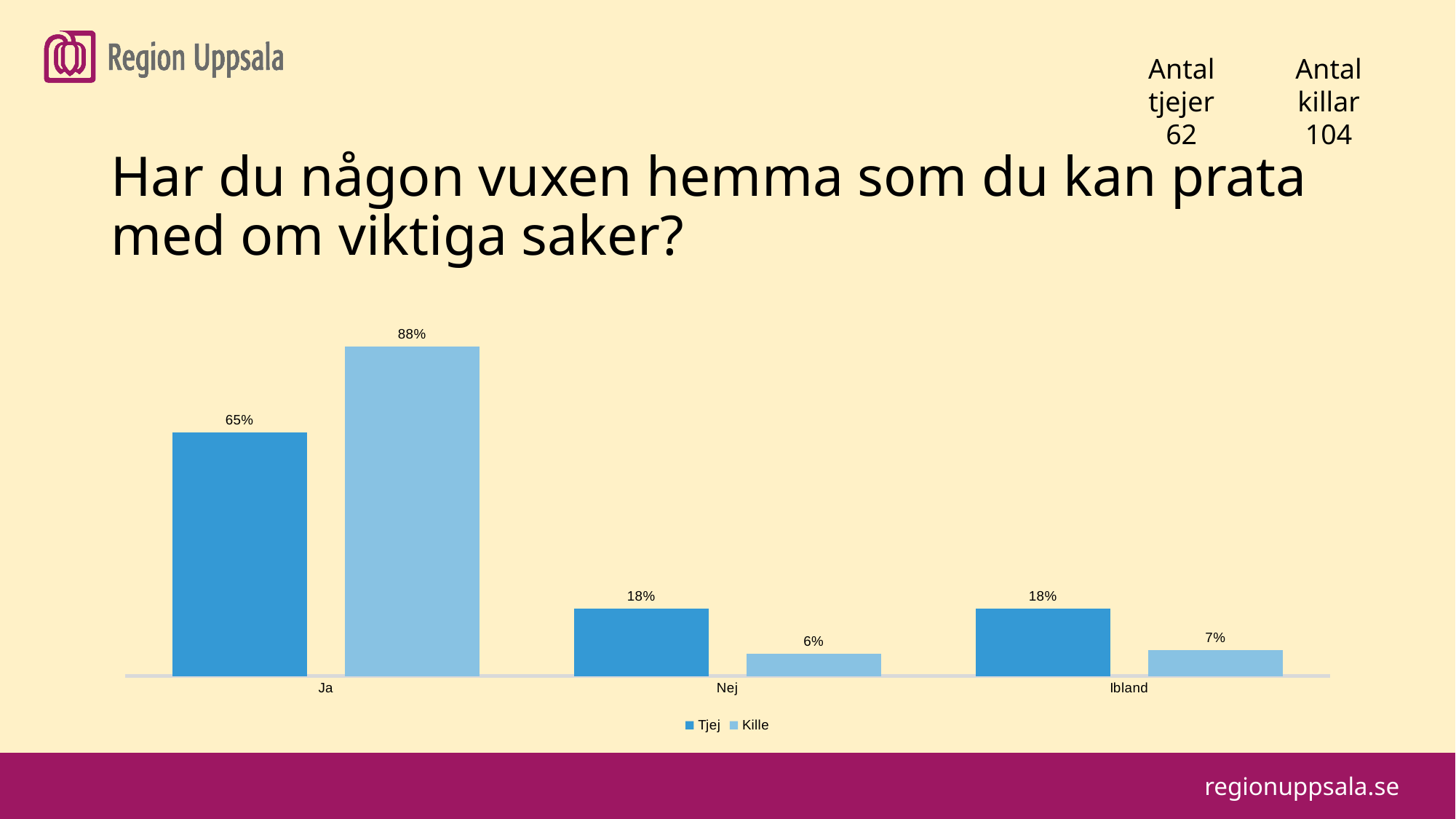
How many series does the legend list? 2 What is the value for Tjej in the Ja category? 65% What is the value for Tjej in the Ibland category? 18% What are the two series names listed in the legend? Tjej and Kille What is the value for Kille in the Nej category? 6% What is the value for Kille in the Ja category? 88% How many categories are shown on the x axis? 3 What kind of chart is shown on the slide? Bar chart Which category has the highest value for the Kille series? Ja In the Nej category, which series has the larger value, Tjej or Kille? Tjej Which category has the lowest value for the Kille series? Nej What is the difference between the Kille and Tjej values in the Ja category? 23%